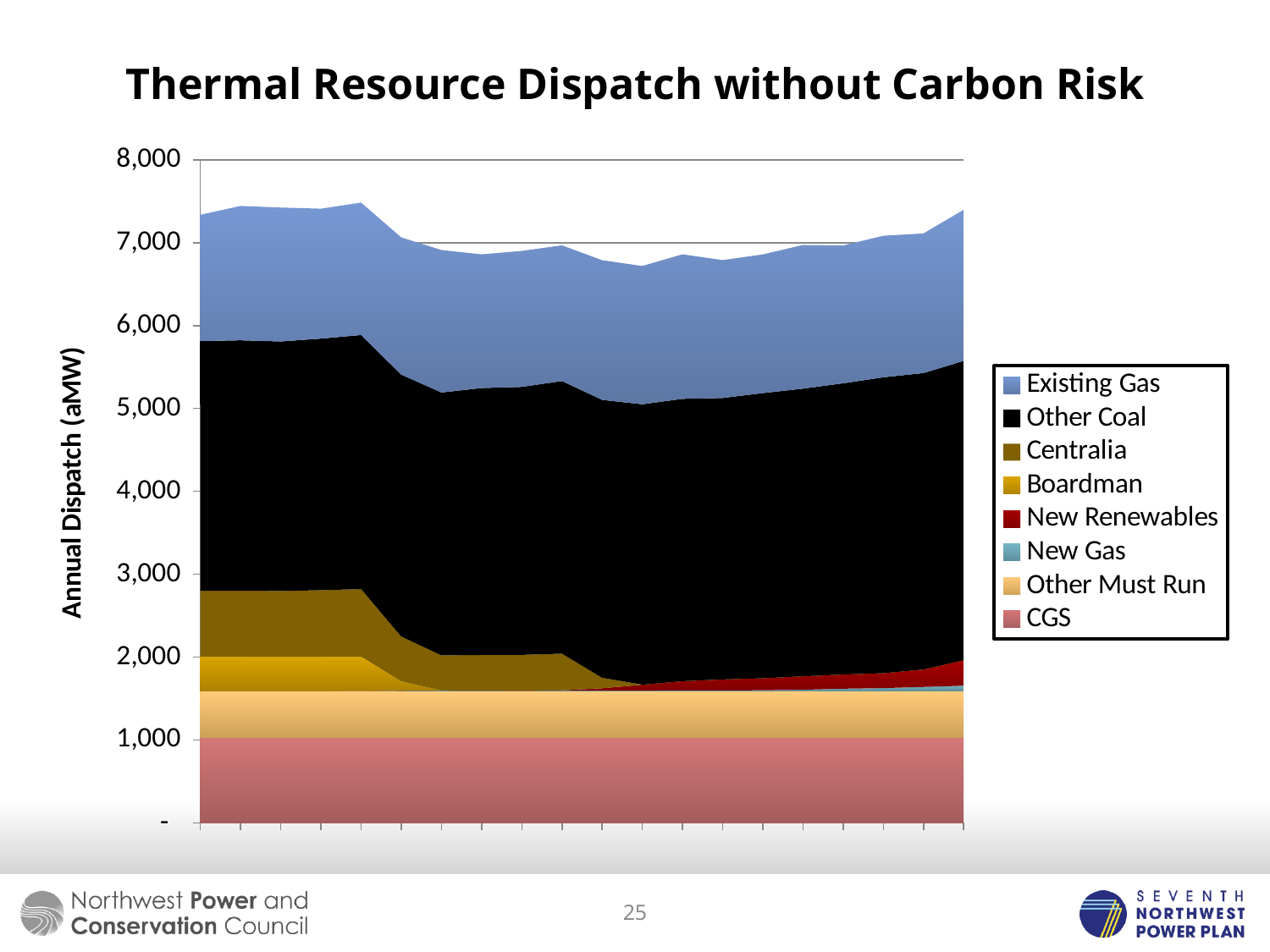
Is the top of the Centralia band at the leftmost point greater or less than 3,000? less Which series is at the bottom of the stack? CGS Does the Boardman band grow or shrink moving left to right along the x axis? shrink Is the total stacked value at the leftmost point greater or less than 7,000? greater What is the title of the chart? Thermal Resource Dispatch without Carbon Risk What kind of chart is shown on the slide? Stacked area chart Which series occupies the largest area of the chart? Other Coal Is the top of the Other Coal band at the leftmost point greater or less than 6,000? less Which series is at the top of the stack? Existing Gas How many series does the legend list? 8 What is the label on the vertical axis? Annual Dispatch (aMW) Does the New Renewables band grow or shrink moving left to right along the x axis? grow